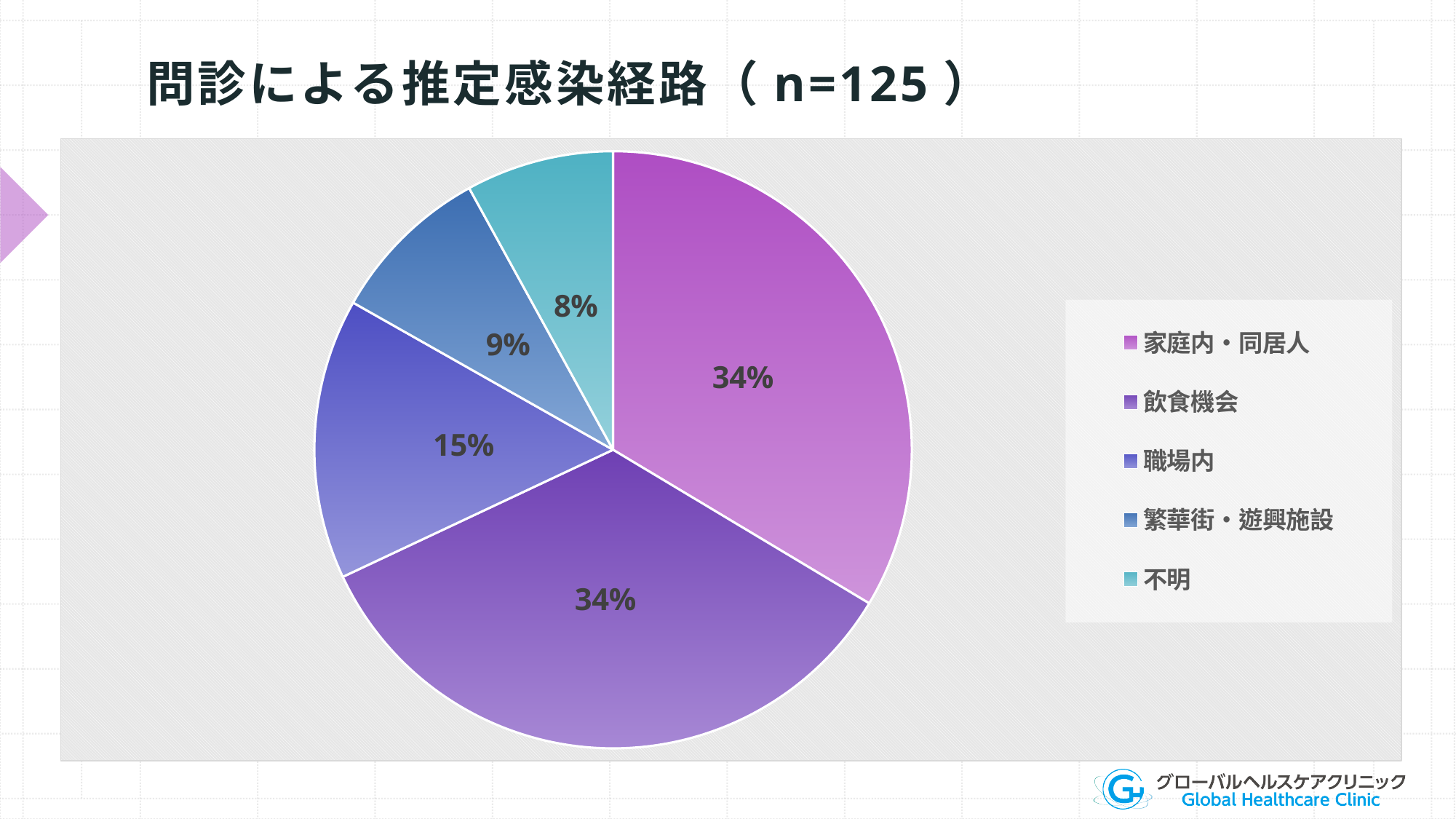
What share of the pie does 不明 account for? 8% What is the difference in percentage points between 職場内 and 不明? 7 Which is larger, the slice for 職場内 or the slice for 繁華街・遊興施設? 職場内 Which category has the smallest slice of the pie? 不明 What share of the pie does 家庭内・同居人 account for? 34% What share of the pie does 繁華街・遊興施設 account for? 9% What is the title of the chart? 問診による推定感染経路（n=125） What is the sample size (n) stated in the chart title? 125 How many categories does the pie chart show? 5 What kind of chart is shown on the slide? pie chart